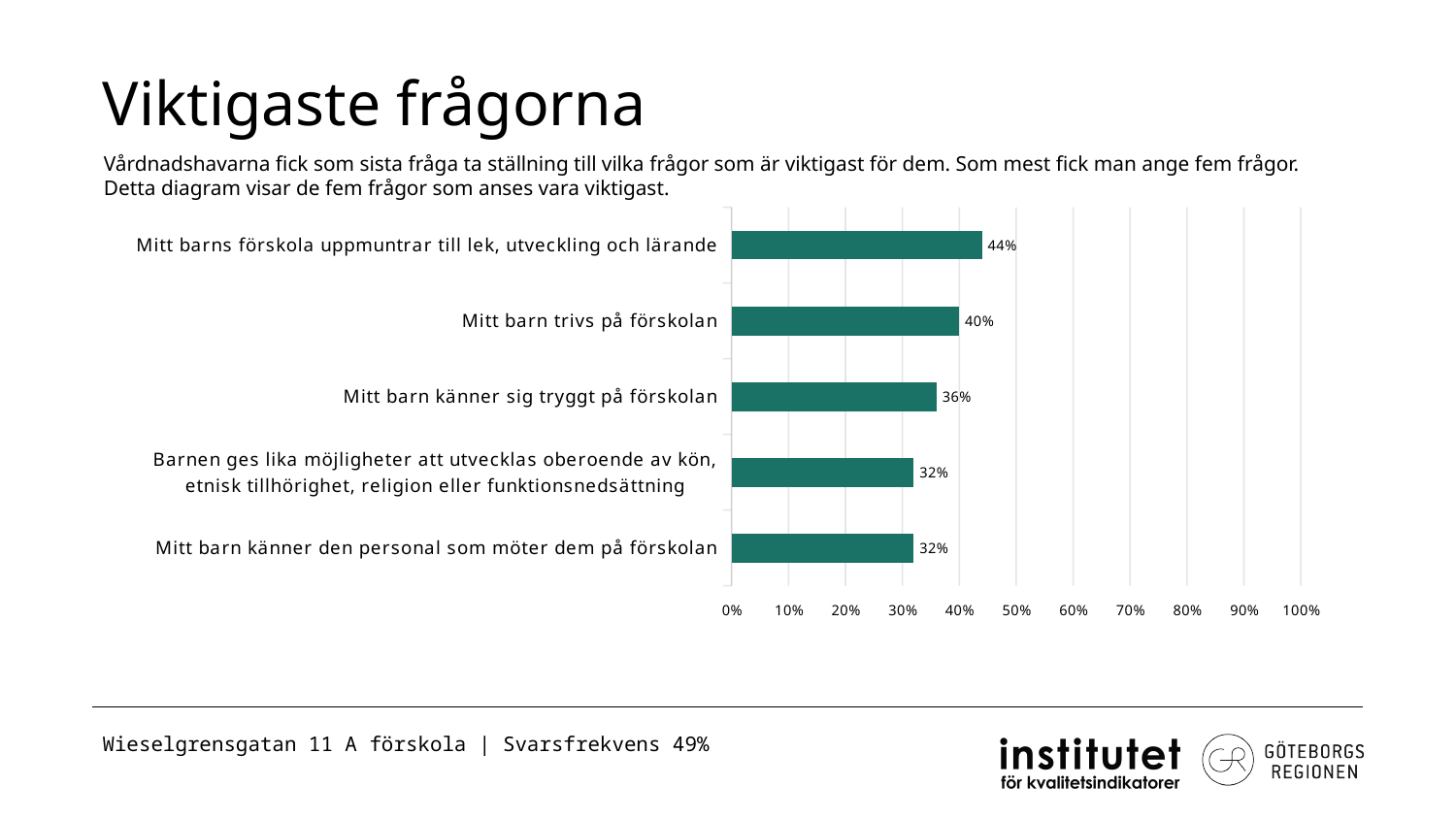
What is the difference between the values for "Mitt barns förskola uppmuntrar till lek, utveckling och lärande" and "Mitt barn trivs på förskolan"? 4% Which category has the highest value? Mitt barns förskola uppmuntrar till lek, utveckling och lärande Which is larger: the value for "Mitt barn känner sig tryggt på förskolan" or the value for "Mitt barn känner den personal som möter dem på förskolan"? Mitt barn känner sig tryggt på förskolan What is the value for "Mitt barn känner sig tryggt på förskolan"? 36% What is the value for "Mitt barn känner den personal som möter dem på förskolan"? 32% What is the value for "Mitt barn trivs på förskolan"? 40% What is the value for "Mitt barns förskola uppmuntrar till lek, utveckling och lärande"? 44% What kind of chart is shown on the slide? Bar chart How many categories are shown in the chart? 5 Is the value for "Mitt barn trivs på förskolan" greater or less than 50%? less What is the title of the slide containing the chart? Viktigaste frågorna What is the difference between the values for "Mitt barn trivs på förskolan" and "Mitt barn känner sig tryggt på förskolan"? 4%